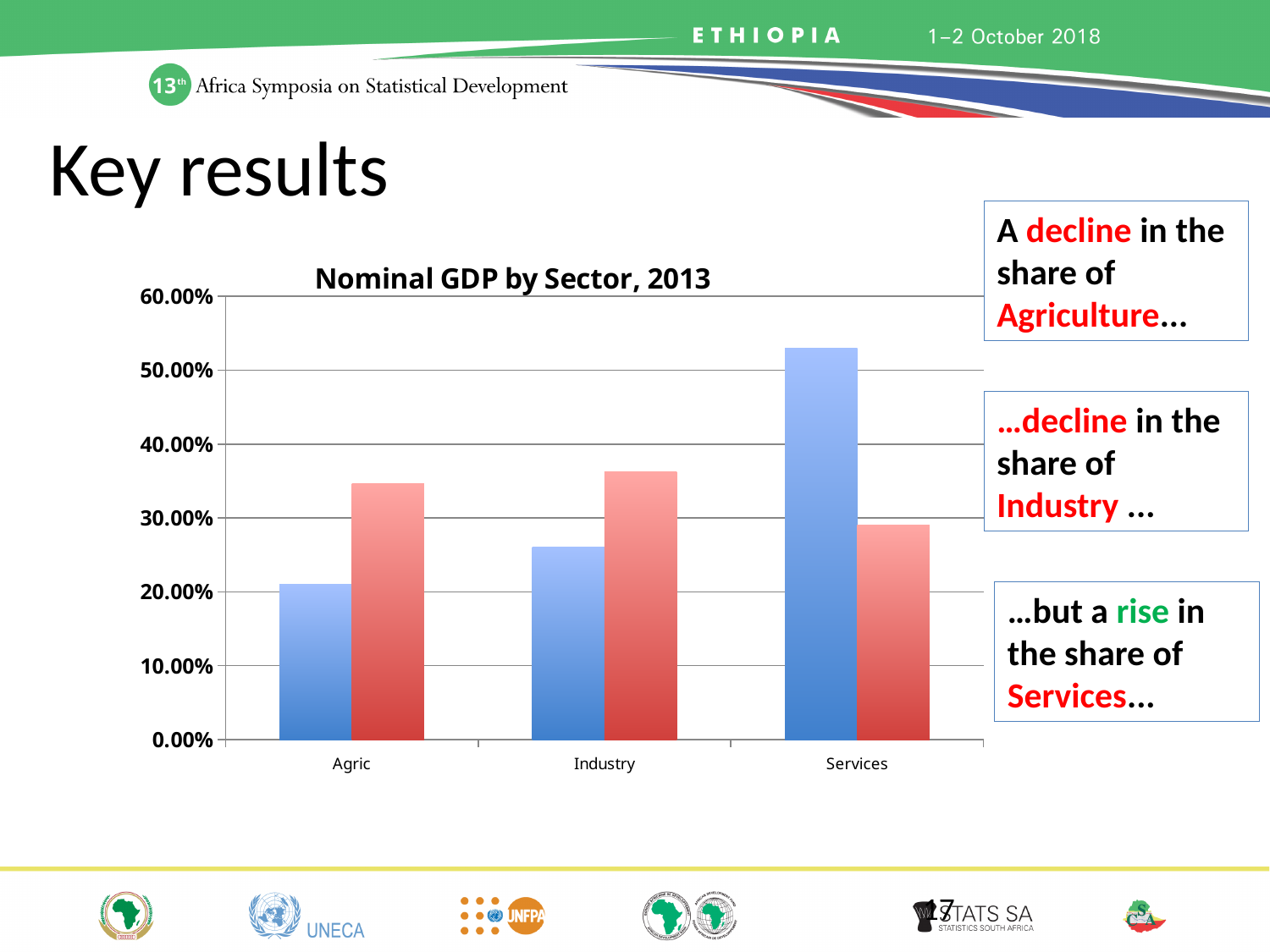
Which sector has the tallest blue bar in the chart? Services Which sector has the shortest red bar in the chart? Services How many sector categories are shown on the x axis of the chart? 3 Is the blue bar for Services greater or less than 50.00%? greater What is the title of the chart? Nominal GDP by Sector, 2013 For Services, which bar is taller, the blue bar or the red bar? the blue bar Is the blue bar for Agric greater or less than 30.00%? less For Agric, which bar is taller, the blue bar or the red bar? the red bar Is the red bar for Industry greater or less than 30.00%? greater What kind of chart is shown on the slide? bar chart Which sector has the shortest blue bar in the chart? Agric